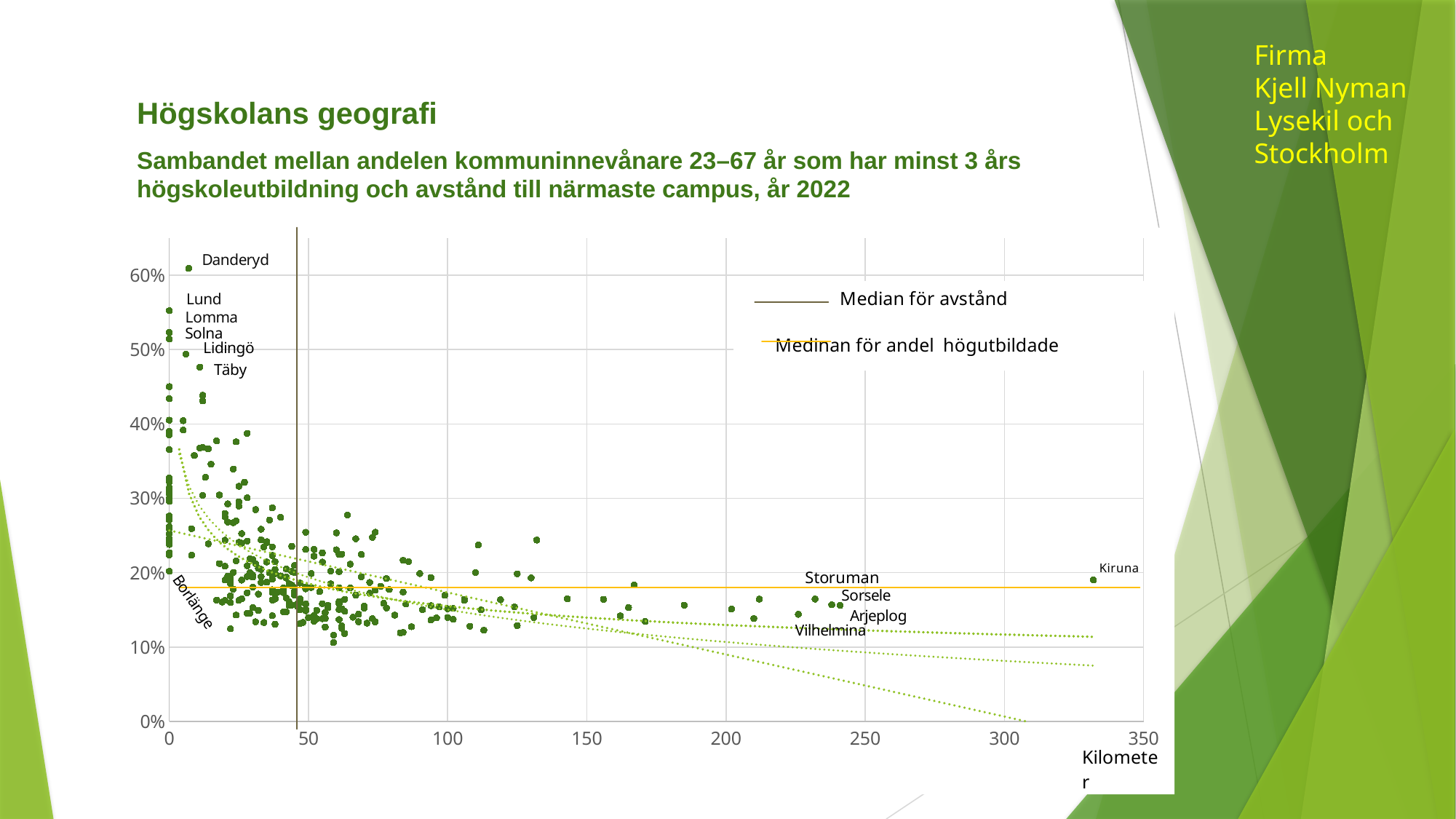
Is the distance for Kiruna greater or less than 300 kilometres? greater What is the highest tick value shown on the y axis? 60% How many entries does the chart legend list? 2 Which has a higher share of highly educated residents, Danderyd or Kiruna? Danderyd Which labelled municipality has the highest share of highly educated residents? Danderyd What kind of chart is shown on the slide? scatter plot Which labelled municipality is farthest from the nearest campus? Kiruna What unit is shown on the x axis of the chart? Kilometer Is the 'Median för avstånd' line at a distance greater or less than 50 kilometres? less Is the share for Täby greater or less than 40%? greater